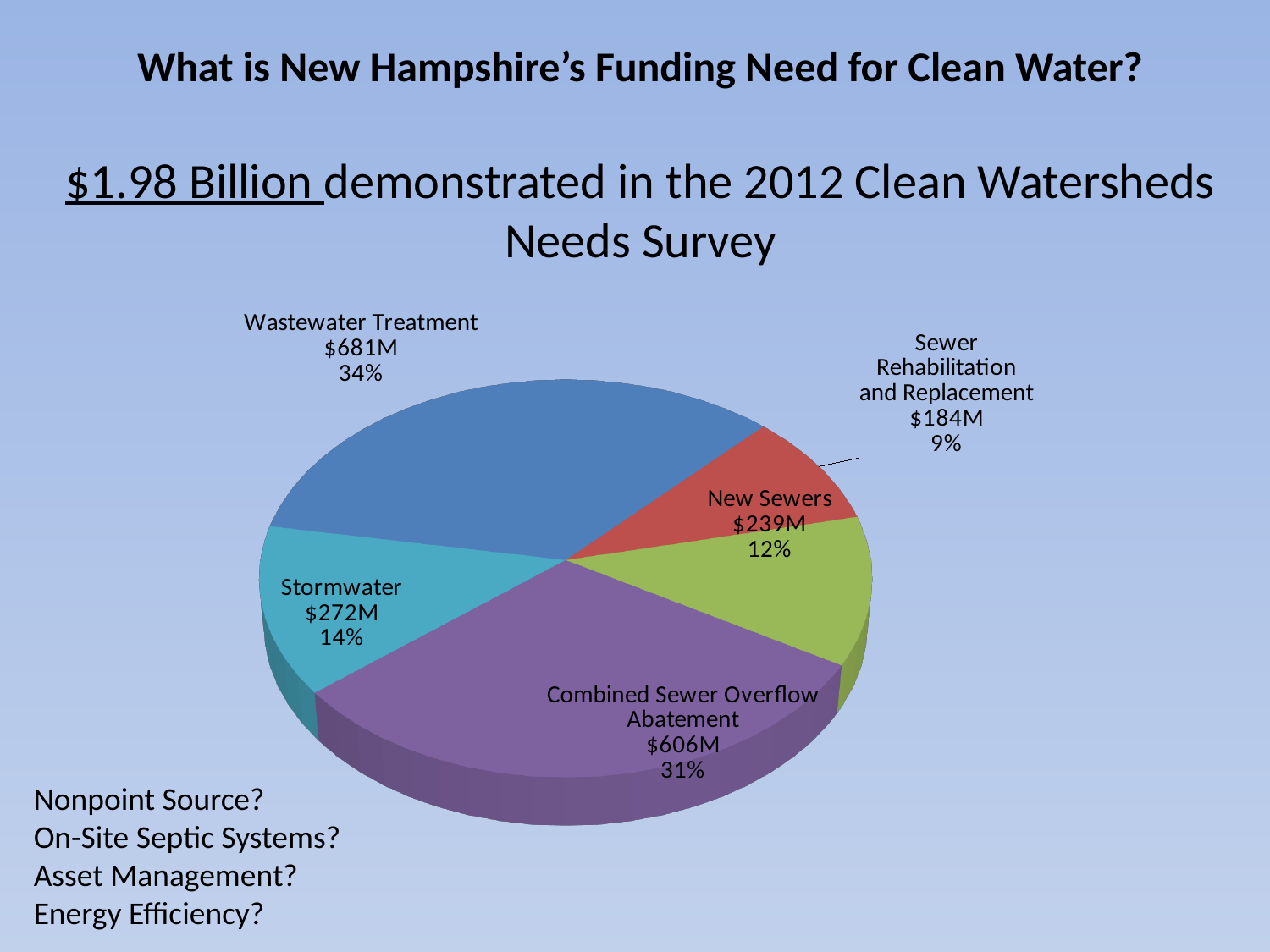
What kind of chart is shown on the slide? Pie chart What is the difference between the values for Wastewater Treatment and Combined Sewer Overflow Abatement? $75M What share of the pie does Wastewater Treatment represent? 34% What is the value for Stormwater? $272M Which category has the largest value? Wastewater Treatment Which category has the smallest value? Sewer Rehabilitation and Replacement What share of the pie does New Sewers represent? 12% What is the value for Sewer Rehabilitation and Replacement? $184M How many slices does the pie chart have? 5 What is the value for Combined Sewer Overflow Abatement? $606M Which is larger, the value for Stormwater or the value for New Sewers? Stormwater What is the value for Wastewater Treatment? $681M